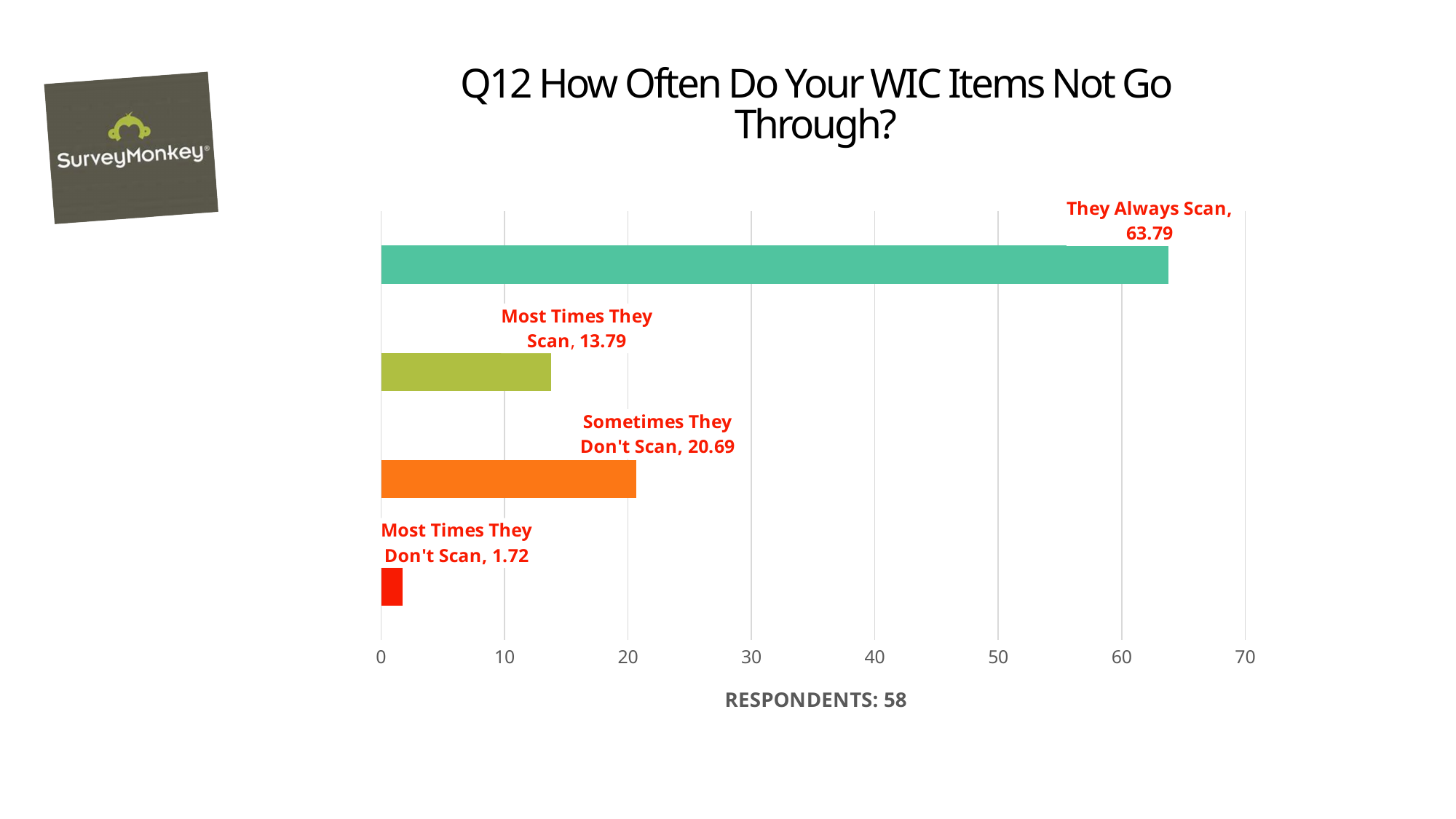
How many categories are shown in the chart? 4 What is the value for "Most Times They Scan"? 13.79 Which category has the lowest value? Most Times They Don't Scan What is the value for "Most Times They Don't Scan"? 1.72 How many respondents does the slide report? 58 What is the value for "They Always Scan"? 63.79 Is the value for "They Always Scan" greater or less than 60? greater What kind of chart is shown on the slide? bar chart What is the difference between the values for "They Always Scan" and "Sometimes They Don't Scan"? 43.1 Which category has the highest value? They Always Scan What is the value for "Sometimes They Don't Scan"? 20.69 Which is larger, the value for "Most Times They Scan" or the value for "Sometimes They Don't Scan"? Sometimes They Don't Scan